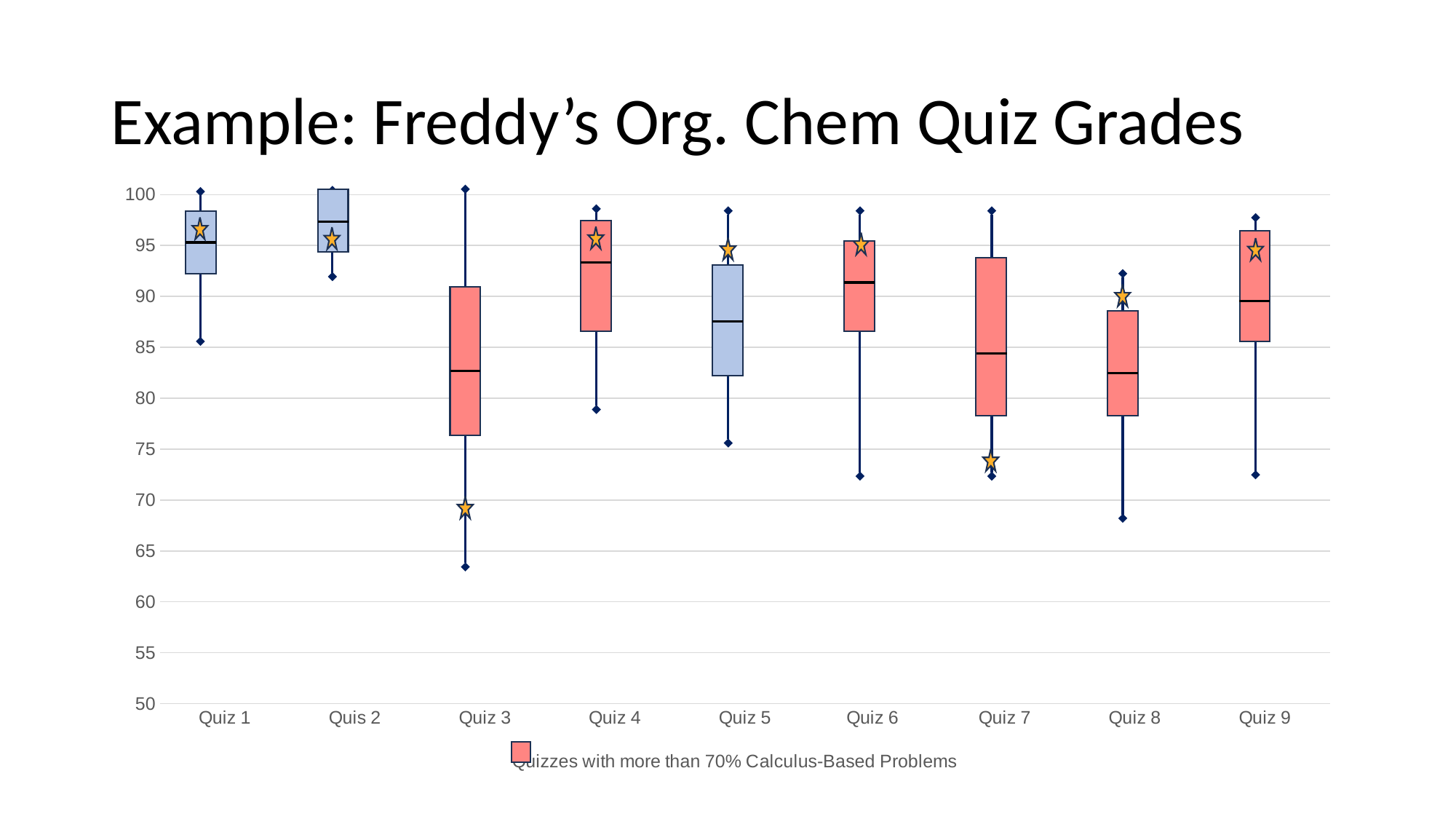
Which has the higher median, Quiz 6 or Quiz 7? Quiz 6 Is the median for Quiz 4 greater or less than 90? greater How many of the boxes are coloured blue rather than red? 3 Which quiz has the highest median line? Quis 2 What kind of chart is shown on the slide? Box plot (box-and-whisker chart) Is the median for Quiz 3 greater or less than 85? less What does the legend entry say? Quizzes with more than 70% Calculus-Based Problems Which has the higher median, Quiz 4 or Quiz 5? Quiz 4 Which quiz has the lowest minimum (bottom whisker) value? Quiz 3 How many quizzes are plotted along the x axis? 9 How many entries does the legend list? 1 Is the minimum whisker value for Quiz 3 greater or less than 65? less